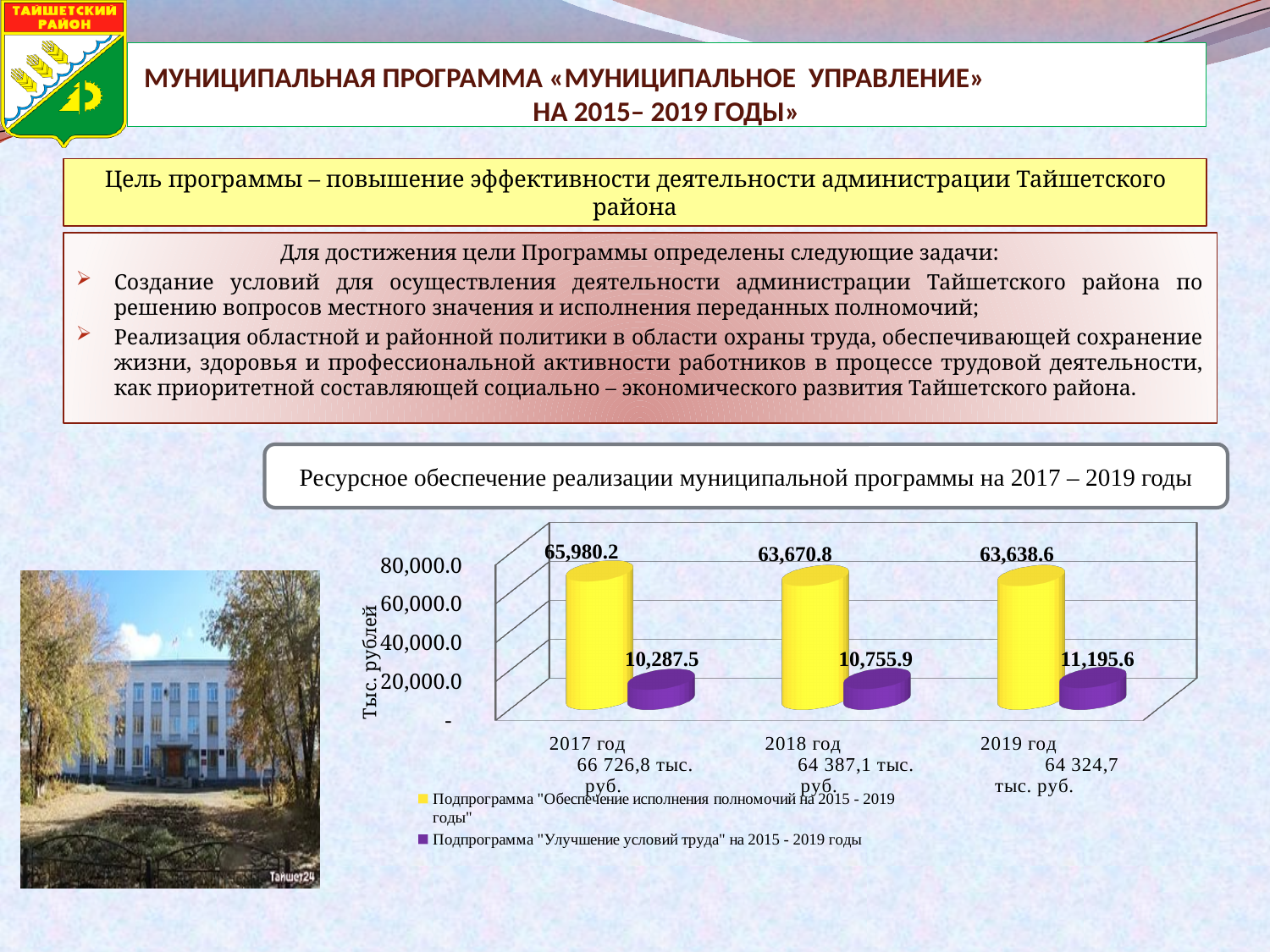
How many series does the chart legend list? 2 What type of chart is shown on the slide? bar chart What is the value for the 'Улучшение условий труда' subprogram in 2019 год? 11,195.6 In which year is the 'Улучшение условий труда' subprogram value lowest? 2017 год By how much does the 'Улучшение условий труда' value in 2019 год exceed its value in 2017 год? 908.1 What is the value for the 'Улучшение условий труда' subprogram in 2018 год? 10,755.9 How many years are shown on the x axis of the chart? 3 Which is larger: the 'Обеспечение исполнения полномочий' value in 2018 год or in 2019 год? 2018 год What is the difference between the two subprogram values in 2017 год? 55,692.7 Do the values for the 'Улучшение условий труда' subprogram rise or fall from 2017 to 2019? rise In which year is the 'Обеспечение исполнения полномочий' subprogram value highest? 2017 год What is the value for the 'Обеспечение исполнения полномочий' subprogram in 2017 год? 65,980.2